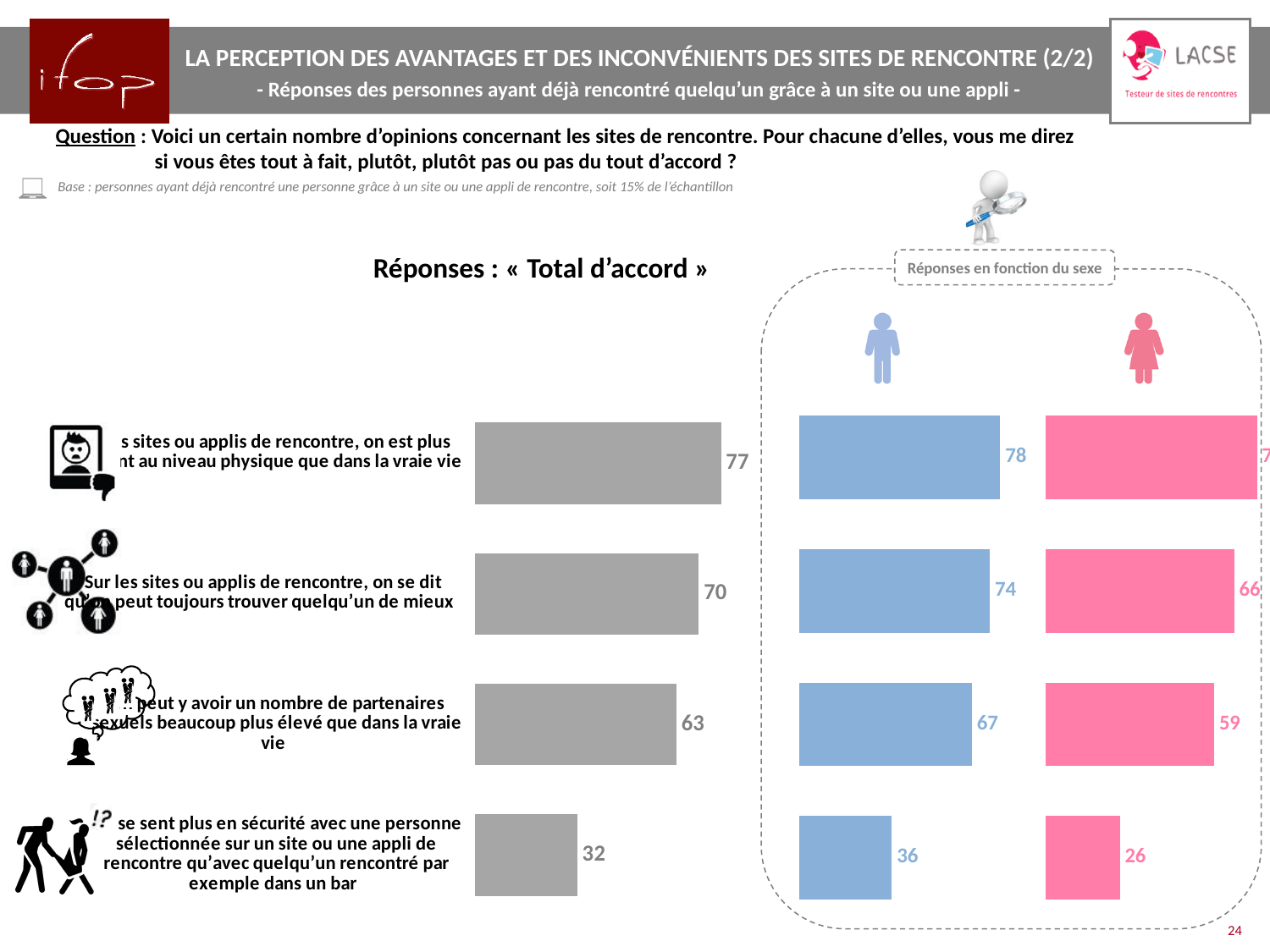
In the men's (blue) chart, what is the value for the statement about the number of sexual partners being much higher than in real life? 67 What is the difference between the men's and women's values for the statement about feeling safer with a person selected on a dating site or app? 10 Which colour represents the women's responses in the 'Réponses en fonction du sexe' section? Pink In the 'Total d'accord' chart, which statement has the lowest value? Feeling safer with a person selected on a dating site or app than with someone met in a bar What type of chart is used to show the 'Total d'accord' responses? Bar chart In the 'Total d'accord' chart, what is the value for the statement that on dating sites or apps one tells oneself one can always find someone better? 70 How many statements are plotted in the 'Total d'accord' chart? 4 In the 'Total d'accord' chart, what is the difference between the first statement (77) and the statement about the number of sexual partners (63)? 14 In the 'Total d'accord' chart, which statement has the highest value? The first statement (on dating sites or apps, one is more ... at the physical level than in real life) For the statement about always being able to find someone better, which is larger: the men's value or the women's value? Men's value (74) In the women's (pink) chart, what is the value for the statement about feeling safer with a person selected on a dating site or app? 26 In the 'Total d'accord' chart, what is the value for the statement about feeling safer with a person selected on a dating site or app than with someone met in a bar? 32